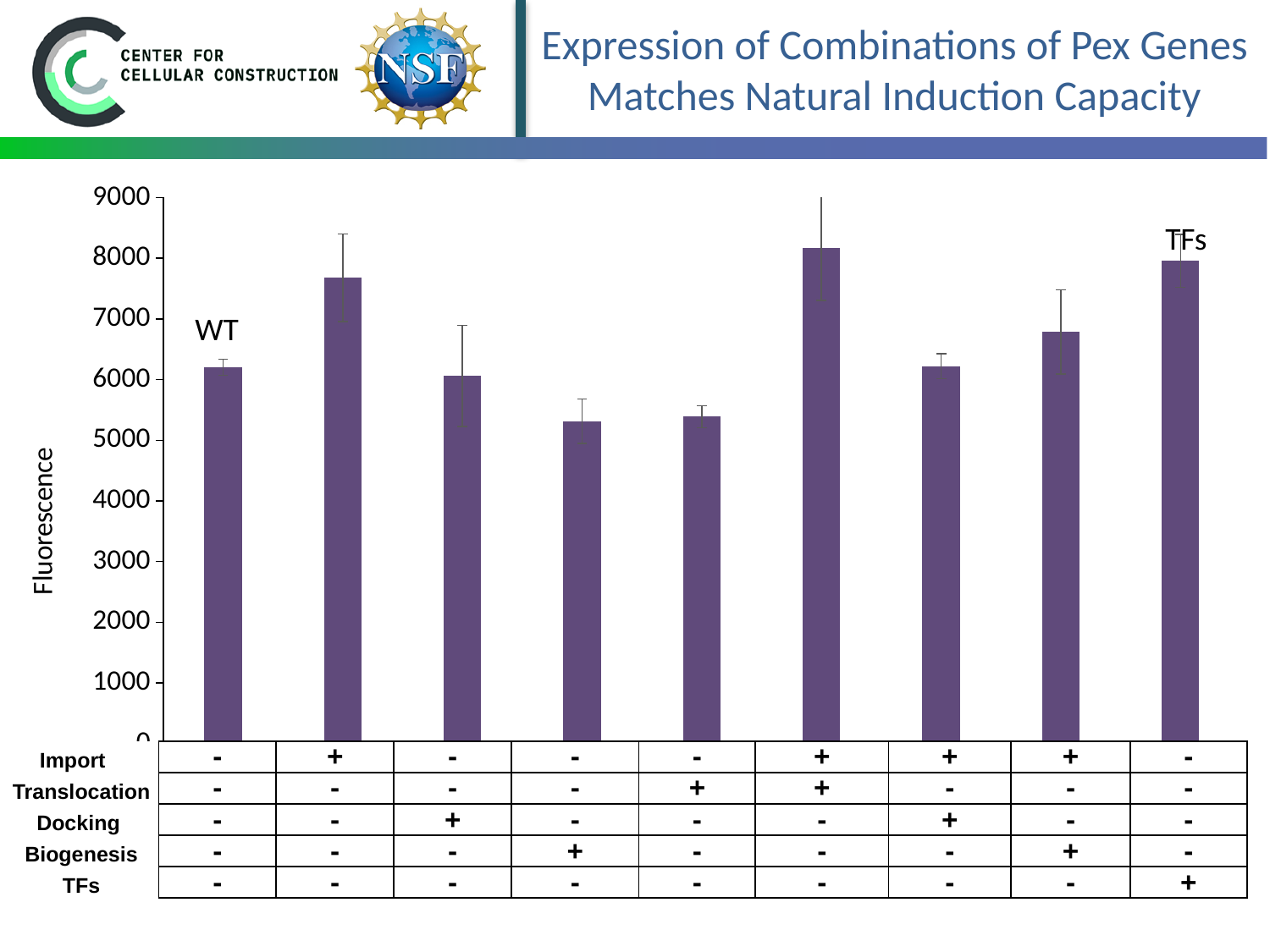
Is the value for the bar with only Import '+' greater or less than 7000? greater Which is larger: the bar with only Docking '+' or the bar with Import '+' and Translocation '+'? the bar with Import '+' and Translocation '+' Is the value for the TFs bar greater or less than 7000? greater What is the label of the y-axis? Fluorescence Which is larger: the WT bar or the bar with only Import '+'? the bar with only Import '+' What is the highest value shown on the y-axis? 9000 Is the value for the bar with only Biogenesis '+' greater or less than 6000? less Which is larger: the bar with only Translocation '+' or the TFs bar? the TFs bar What kind of chart is shown on the slide? bar chart How many bars are plotted in the chart? 9